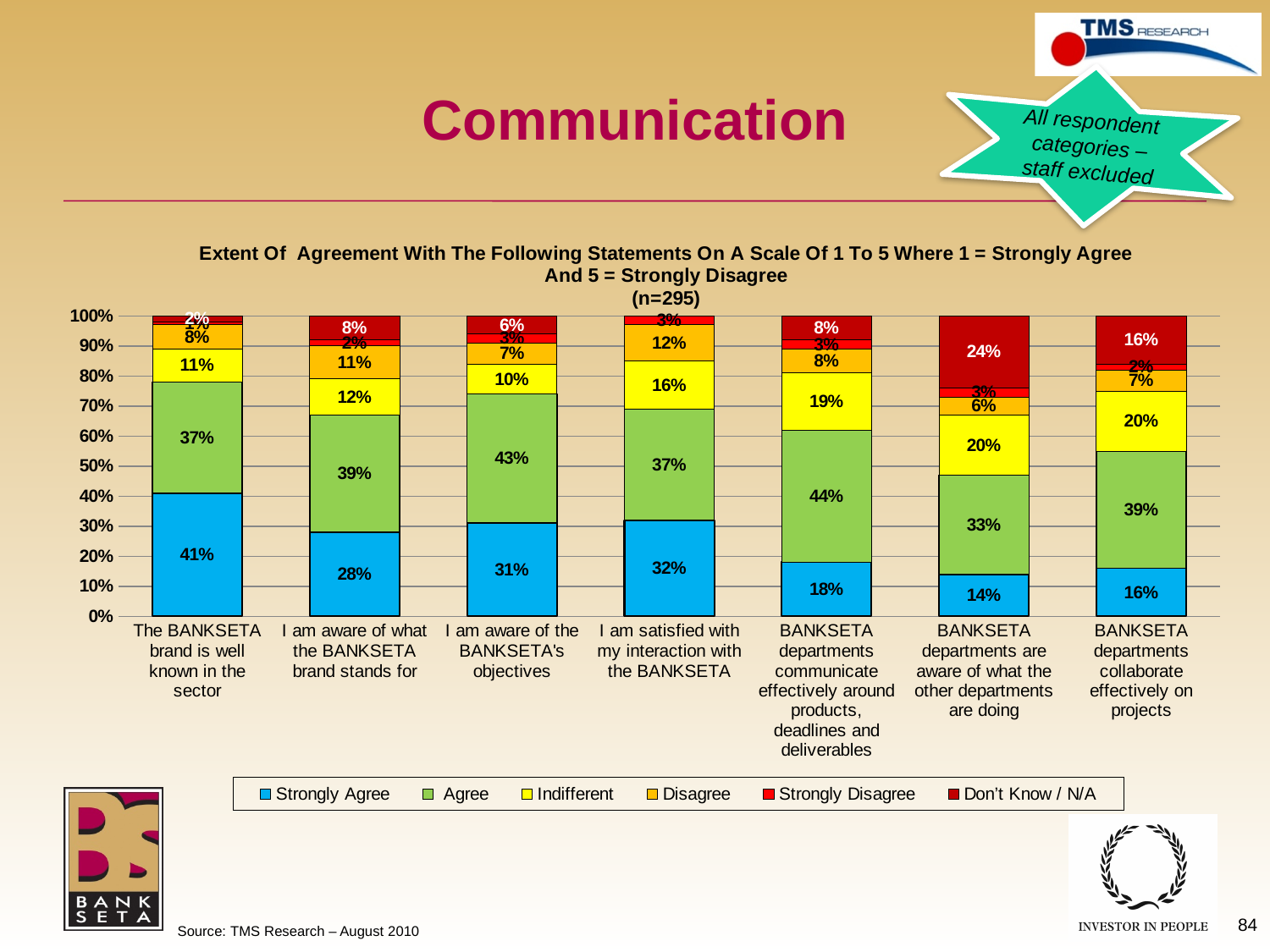
How many series does the chart legend list? 6 What is the difference between the Agree percentage for 'I am aware of the BANKSETA's objectives' and the Agree percentage for 'BANKSETA departments are aware of what the other departments are doing'? 10% What type of chart is shown on the slide? Stacked bar chart Which statement has the highest Strongly Agree percentage? The BANKSETA brand is well known in the sector What is the Don't Know / N/A share for the statement 'BANKSETA departments are aware of what the other departments are doing'? 24% Which statement has the lowest Strongly Agree percentage? BANKSETA departments are aware of what the other departments are doing How many statements (categories) are shown on the x axis of the chart? 7 What percentage of respondents are indifferent to the statement 'I am satisfied with my interaction with the BANKSETA'? 16% What percentage of respondents strongly agree that the BANKSETA brand is well known in the sector? 41% Which is larger: the Strongly Agree share for 'I am aware of what the BANKSETA brand stands for' or for 'I am satisfied with my interaction with the BANKSETA'? I am satisfied with my interaction with the BANKSETA What percentage of respondents agree that BANKSETA departments communicate effectively around products, deadlines and deliverables? 44% What is the sample size (n) stated in the chart title? n=295